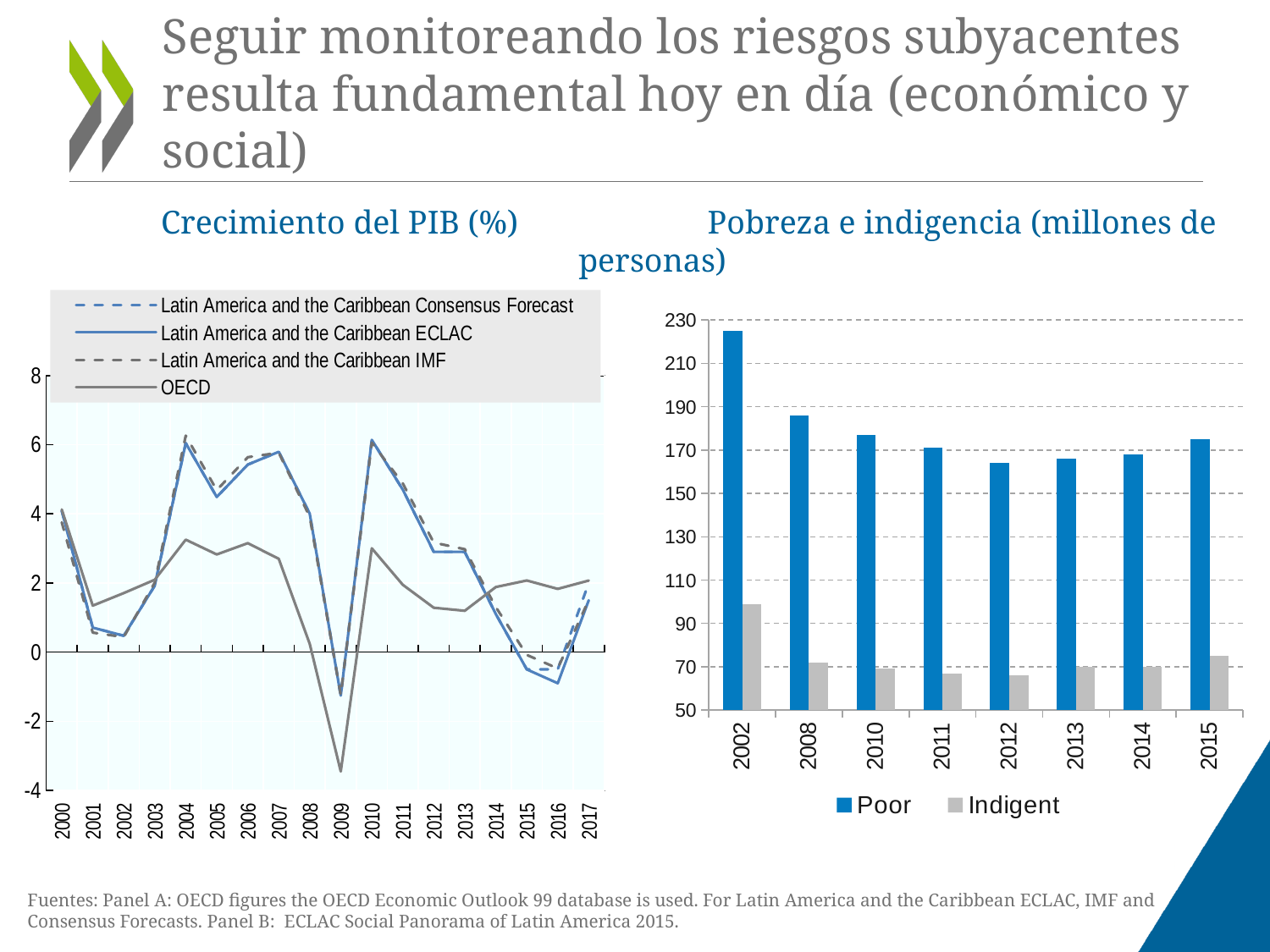
How many years are shown on the x axis of the 'Crecimiento del PIB (%)' chart? 18 In the 'Pobreza e indigencia' chart, is the value for Poor in 2002 greater or less than 210? greater In the 'Pobreza e indigencia' chart, which is larger, Poor in 2008 or Poor in 2010? Poor in 2008 How many series does the legend of the 'Crecimiento del PIB (%)' chart list? 4 How many years are shown on the x axis of the 'Pobreza e indigencia' chart? 8 What kind of chart is the 'Crecimiento del PIB (%)' chart on the left? line chart In the 'Pobreza e indigencia' chart, is the value for Poor in 2012 greater or less than 170? less In the 'Pobreza e indigencia' chart, which year has the highest value for Poor? 2002 How many series does the legend of the 'Pobreza e indigencia' chart list? 2 In the 'Crecimiento del PIB (%)' chart, is the OECD value for 2009 greater or less than -2? less In the 'Pobreza e indigencia' chart, which year has the highest value for Indigent? 2002 What kind of chart is the 'Pobreza e indigencia (millones de personas)' chart on the right? bar chart